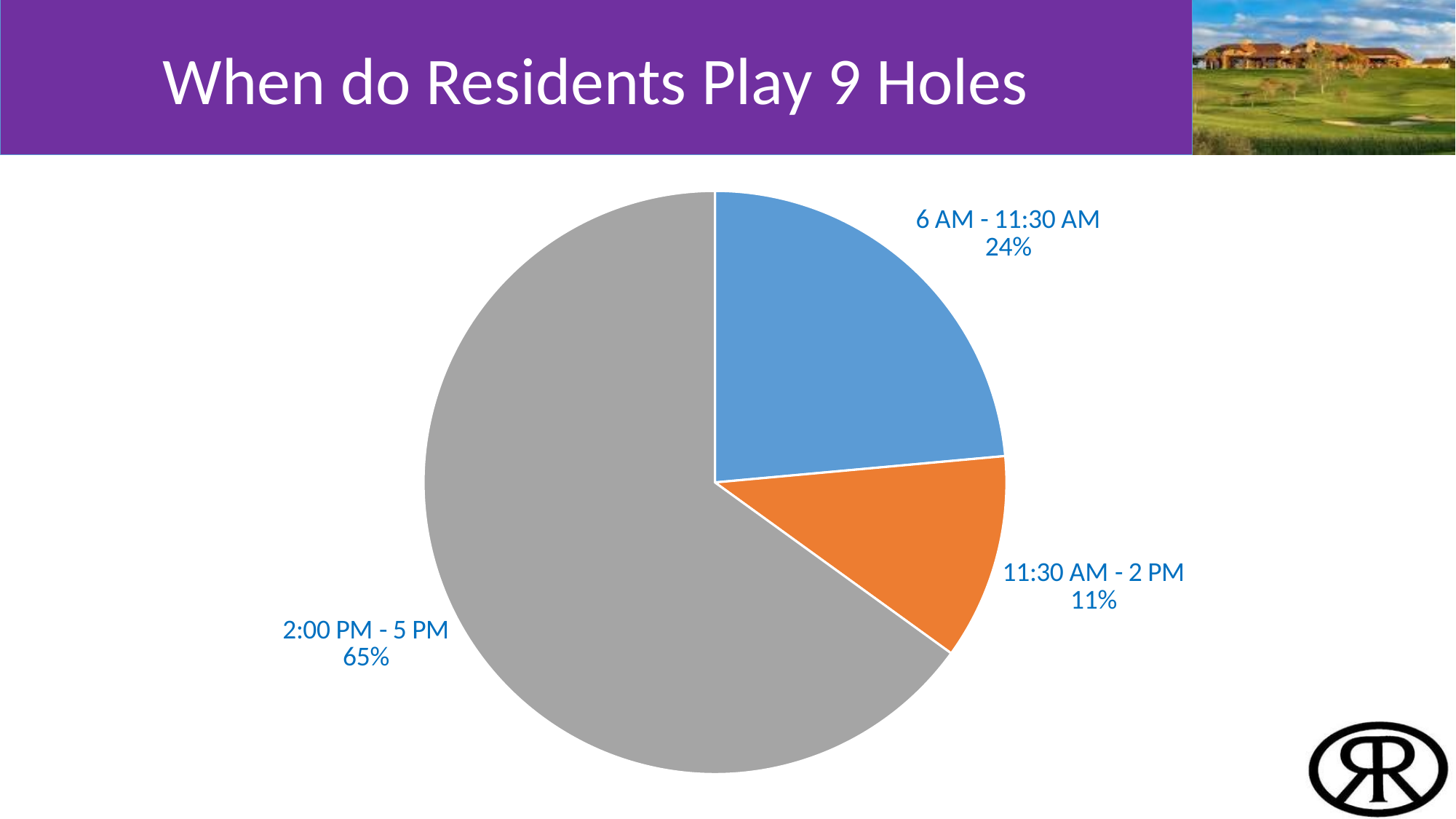
What share of residents play 9 holes between 11:30 AM and 2 PM? 11% What is the difference in percentage points between the 2:00 PM - 5 PM slice and the 6 AM - 11:30 AM slice? 41 percentage points How many time slots are shown in the pie chart? 3 Which slice is larger: 6 AM - 11:30 AM or 11:30 AM - 2 PM? 6 AM - 11:30 AM What share of residents play 9 holes between 6 AM and 11:30 AM? 24% What colour is the 2:00 PM - 5 PM slice? Grey What kind of chart is shown on the slide? Pie chart Which time slot has the smallest share of residents playing 9 holes? 11:30 AM - 2 PM What is the title of the slide? When do Residents Play 9 Holes What share of residents play 9 holes between 2:00 PM and 5 PM? 65% What is the difference in percentage points between the 6 AM - 11:30 AM slice and the 11:30 AM - 2 PM slice? 13 percentage points Which time slot has the largest share of residents playing 9 holes? 2:00 PM - 5 PM